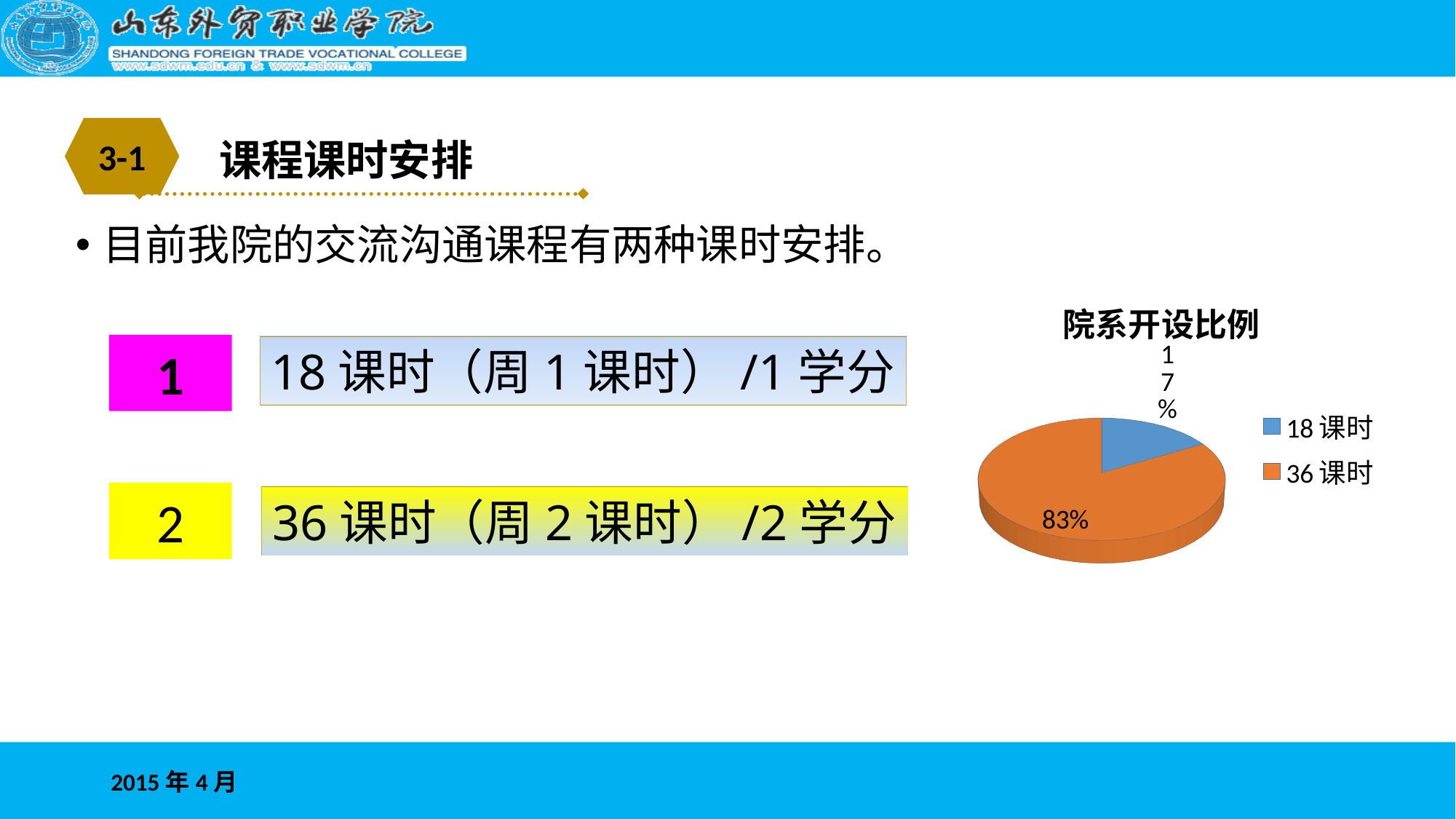
What is the difference in percentage points between the 36 课时 slice and the 18 课时 slice? 66 Is the share for 36 课时 greater or less than 50%? greater Which slice of the pie chart is the smallest? 18 课时 What is the title of the pie chart? 院系开设比例 What share of the pie does 36 课时 take? 83% How many slices does the pie chart have? 2 What kind of chart is shown on the slide? pie chart Which slice of the pie chart is the largest? 36 课时 Which is larger in the pie chart, 18 课时 or 36 课时? 36 课时 What share of the pie does 18 课时 take? 17% Which colour represents 36 课时 in the pie chart? orange How many entries does the legend of the pie chart list? 2